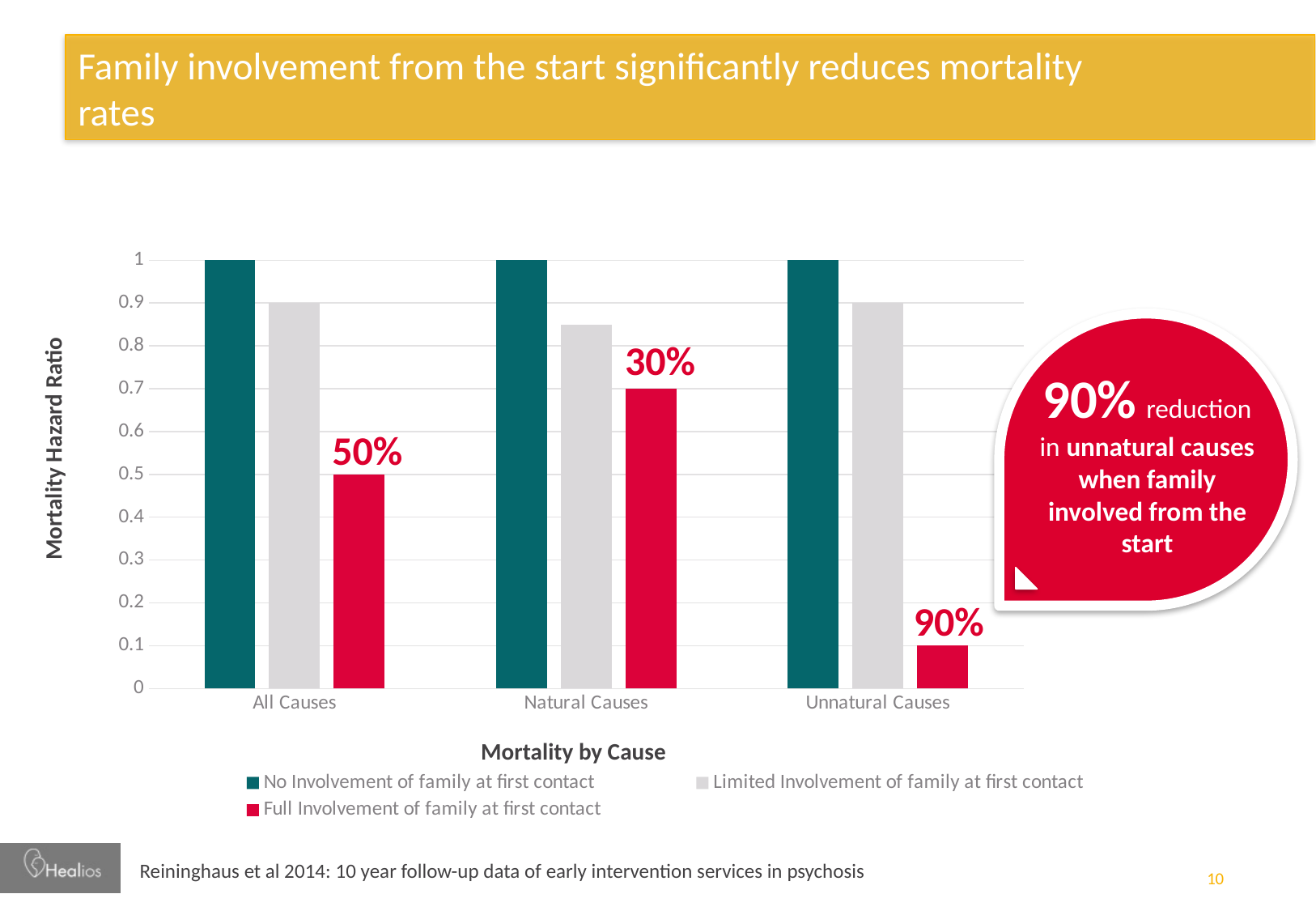
Is the Mortality Hazard Ratio for Limited Involvement of family at first contact for Natural Causes greater or less than 0.8? greater For which cause category is the Full Involvement of family at first contact bar lowest? Unnatural Causes What is the title of the x axis of the chart? Mortality by Cause How many categories are shown on the x axis of the chart? 3 What is the Mortality Hazard Ratio for Limited Involvement of family at first contact for Unnatural Causes? 0.9 What is the difference between the No Involvement and Full Involvement Mortality Hazard Ratios for Natural Causes? 0.3 What kind of chart is shown on the slide? bar chart What is the Mortality Hazard Ratio for Full Involvement of family at first contact for All Causes? 0.5 How many series does the chart's legend list? 3 What is the Mortality Hazard Ratio for Full Involvement of family at first contact for Unnatural Causes? 0.1 What is the Mortality Hazard Ratio for No Involvement of family at first contact for Natural Causes? 1 For which cause category is the Full Involvement of family at first contact bar highest? Natural Causes